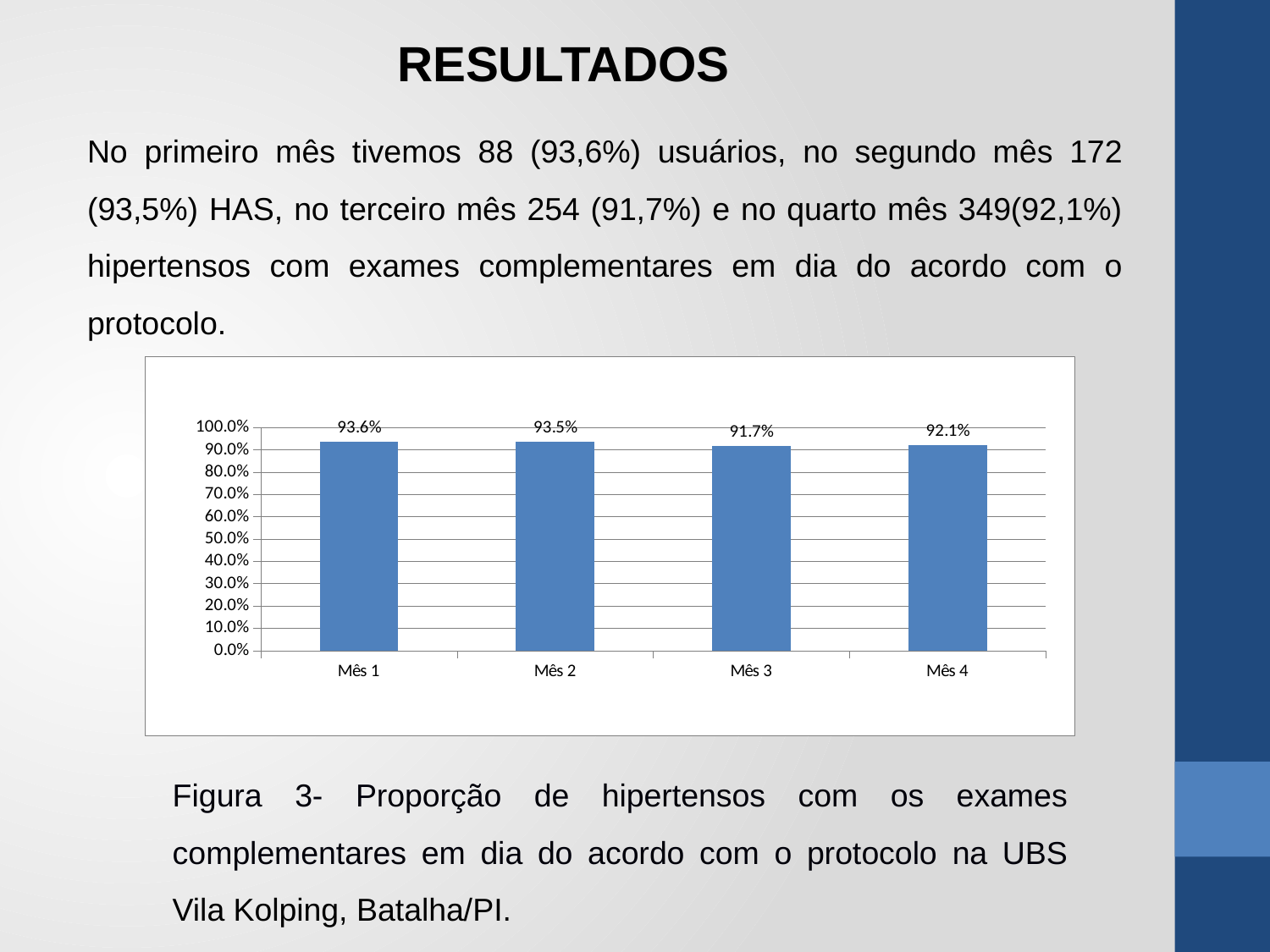
What is the value for Mês 3? 91.7% Which month has the lowest value? Mês 3 What colour are the bars in the chart? blue What is the value for Mês 2? 93.5% How many months are shown on the x axis? 4 What is the value for Mês 4? 92.1% What is the difference between the values for Mês 1 and Mês 3? 1.9% Which month has the highest value? Mês 1 What is the value for Mês 1? 93.6% Which is larger, the value for Mês 1 or the value for Mês 3? Mês 1 What kind of chart is shown on the slide? bar chart Is the value for Mês 2 greater or less than 90.0%? greater